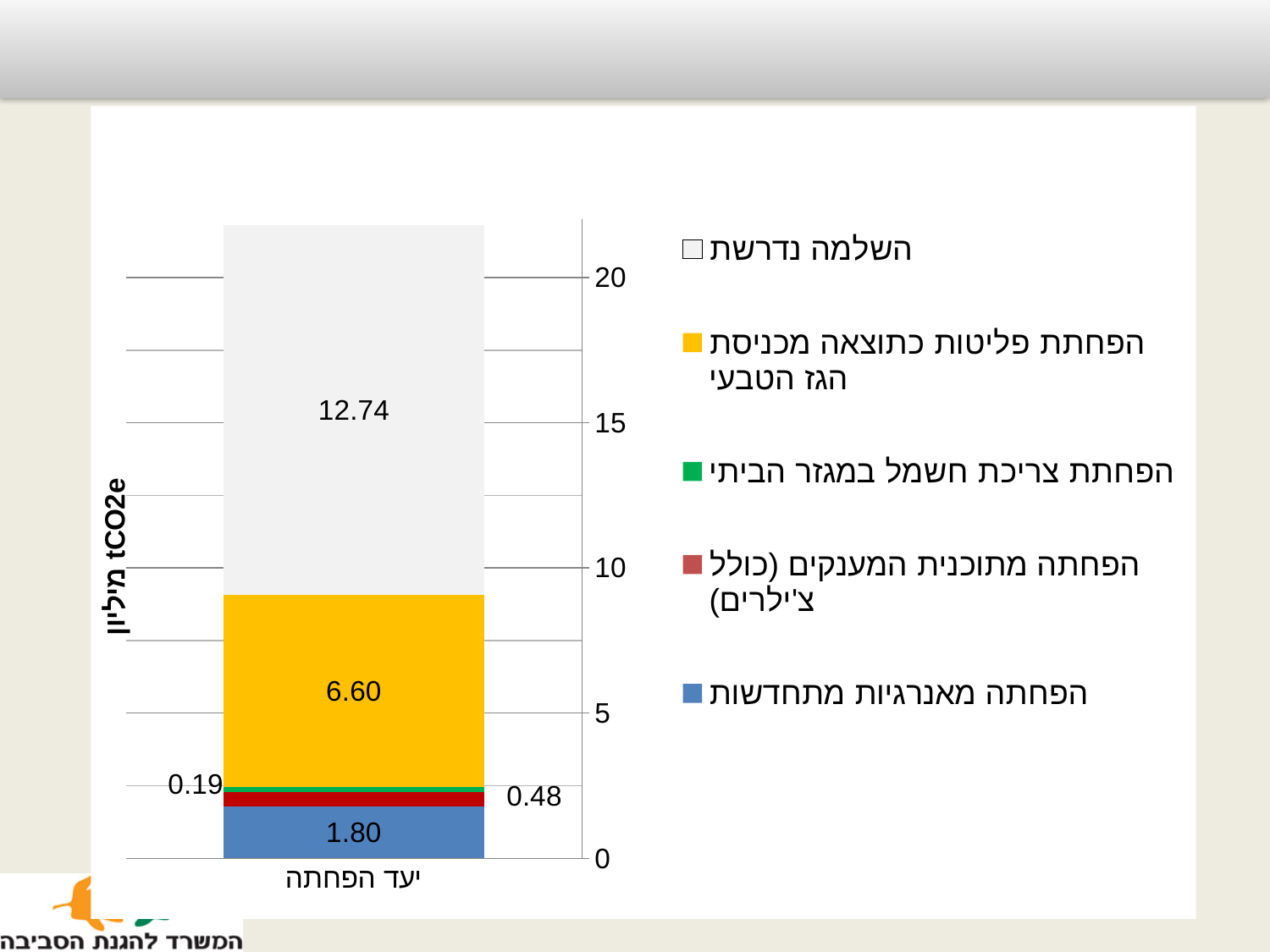
What is the value of the הפחתה מתוכנית המענקים (כולל צ'ילרים) segment? 0.48 What is the total of all segments in the יעד הפחתה bar? 21.81 What is the difference between the השלמה נדרשת segment and the הפחתת פליטות כתוצאה מכניסת הגז הטבעי segment? 6.14 Which segment of the stacked bar has the largest value? השלמה נדרשת What is the value of the הפחתת פליטות כתוצאה מכניסת הגז הטבעי segment? 6.60 What is the value of the השלמה נדרשת segment in the יעד הפחתה bar? 12.74 What is the value of the הפחתה מאנרגיות מתחדשות segment? 1.80 What is the value of the הפחתת צריכת חשמל במגזר הביתי segment? 0.19 How many series does the legend list? 5 What is the label of the vertical axis? מיליון tCO2e What type of chart is shown on the slide? stacked bar chart Which segment of the stacked bar has the smallest value? הפחתת צריכת חשמל במגזר הביתי